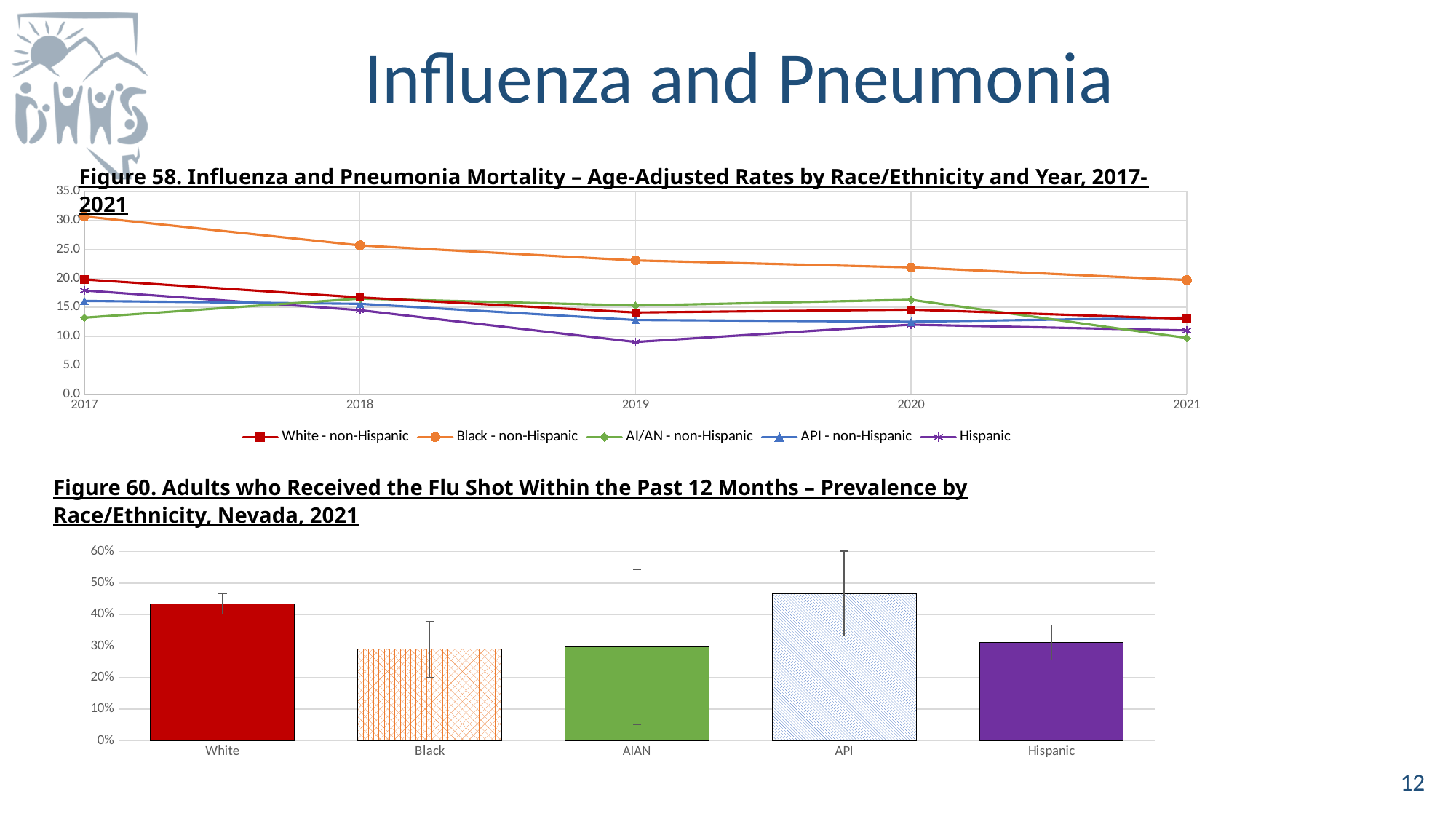
In Figure 60, which race/ethnicity group has the highest flu shot prevalence? API In Figure 58, is the 2019 value for Hispanic greater or less than 10.0? less In Figure 60, which is larger, the value for White or the value for Hispanic? White In Figure 58, how many series does the legend list? 5 In Figure 60, what kind of chart is used? bar chart In Figure 58, which group has the lowest mortality rate in 2019? Hispanic In Figure 58, is the 2019 value for Black - non-Hispanic greater or less than 20.0? greater In Figure 58, what kind of chart is used? line chart In Figure 60, is the value for White greater or less than 40%? greater In Figure 58, does the mortality rate for Black - non-Hispanic rise or fall from 2017 to 2021? fall In Figure 58, which race/ethnicity group has the highest influenza and pneumonia mortality rate in every year shown? Black - non-Hispanic In Figure 58, how many years are plotted on the x axis? 5